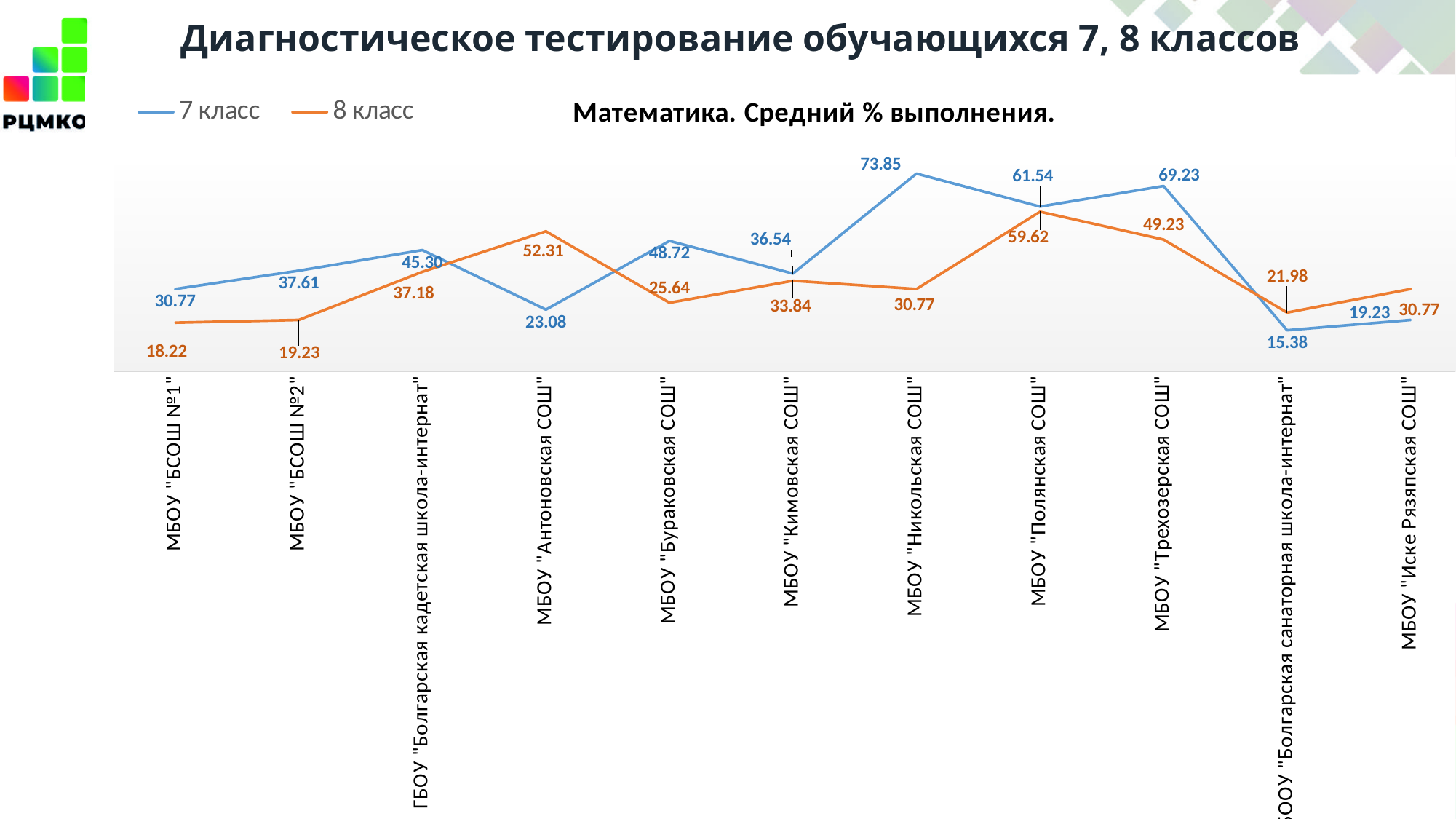
What is the 8 класс value for МБОУ "Антоновская СОШ"? 52.31 Which school has the lowest 7 класс value? ГБООУ "Болгарская санаторная школа-интернат" Which school has the highest 8 класс value? МБОУ "Полянская СОШ" What is the difference between the 7 класс and 8 класс values for МБОУ "Никольская СОШ"? 43.08 Which school has the highest 7 класс value? МБОУ "Никольская СОШ" What kind of chart is shown? line chart What is the title of the chart? Математика. Средний % выполнения. How many series does the legend list? 2 What is the 8 класс value for МБОУ "БСОШ №1"? 18.22 How many schools are shown on the x axis? 11 What is the 7 класс value for МБОУ "Никольская СОШ"? 73.85 For МБОУ "Антоновская СОШ", which is larger: the 7 класс value or the 8 класс value? 8 класс